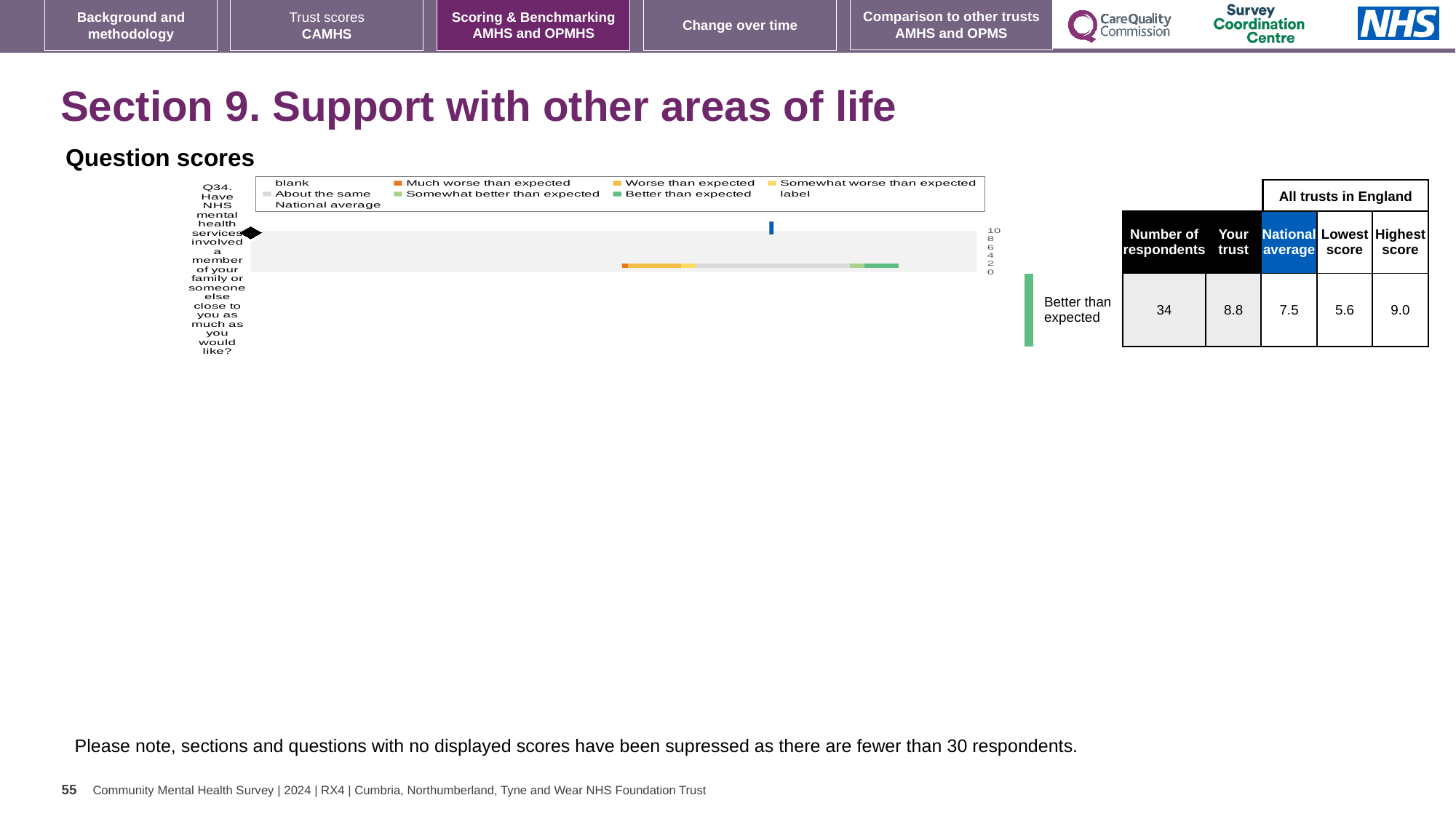
What is the difference between the highest and lowest scores among all trusts in England for Q34? 3.4 What is the difference between the 'Your trust' score and the national average for Q34? 1.3 What kind of chart is shown under 'Question scores'? bar chart What is the highest score among all trusts in England for Q34? 9.0 Which question is plotted in the Question scores chart? Q34 What is the national average score for Q34? 7.5 How many survey questions are plotted in the Question scores chart? 1 What is the number of respondents shown for Q34? 34 Which legend entry in the Question scores chart is shown in orange? Much worse than expected What is the 'Your trust' score for Q34? 8.8 What is the lowest score among all trusts in England for Q34? 5.6 Which is larger for Q34, the 'Your trust' score or the national average? Your trust